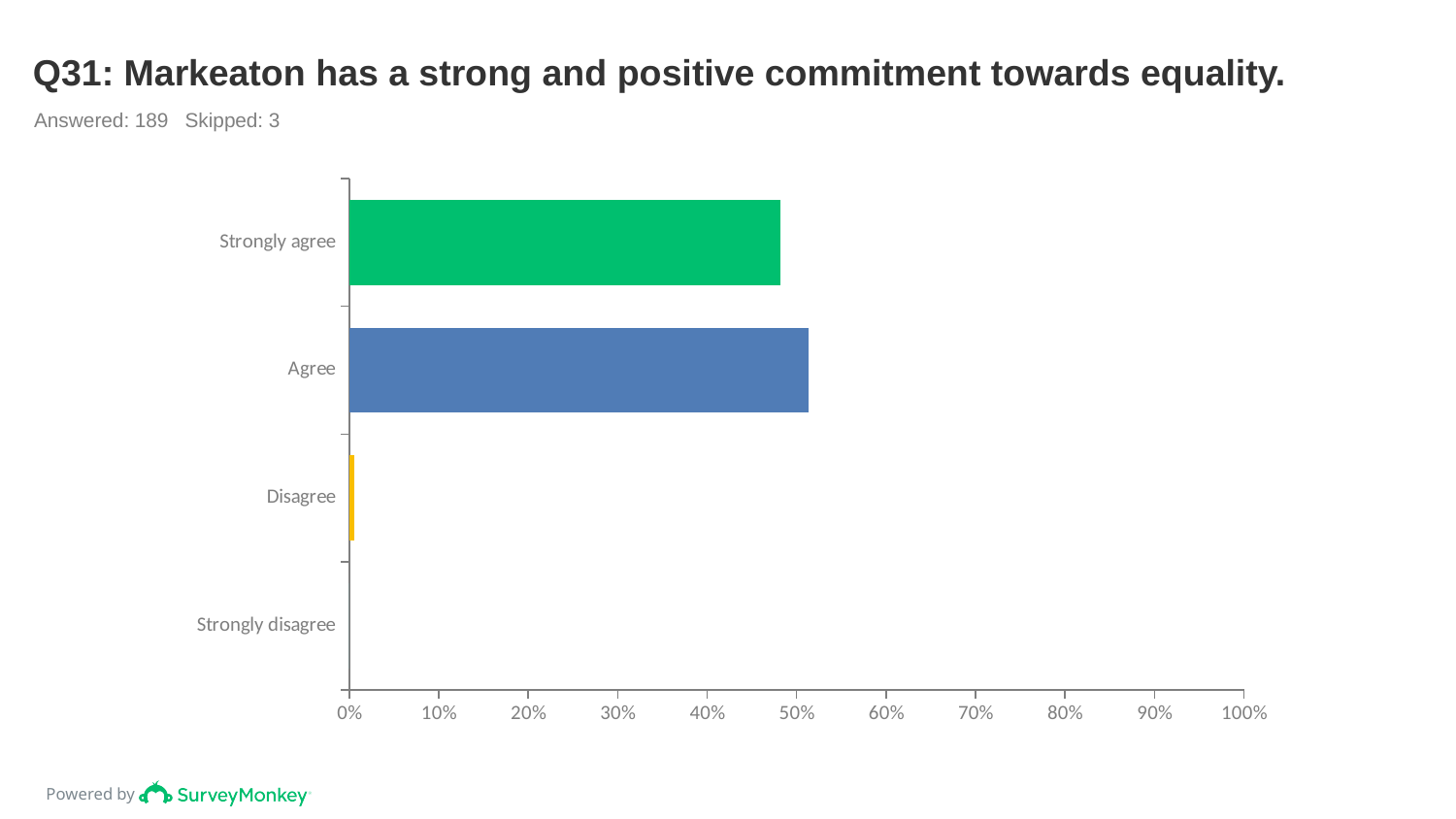
Is the value for Strongly agree greater or less than 40%? greater Which response category has the lowest value? Strongly disagree Which response category has the longest bar? Agree What kind of chart is shown on the slide? bar chart What is the title of the chart? Q31: Markeaton has a strong and positive commitment towards equality. Is the value for Strongly agree greater or less than 50%? less Which is larger, the value for Strongly agree or the value for Strongly disagree? Strongly agree How many respondents answered this question according to the slide? 189 Is the value for Agree greater or less than 50%? greater Which is larger, the value for Agree or the value for Disagree? Agree How many response categories are shown on the chart? 4